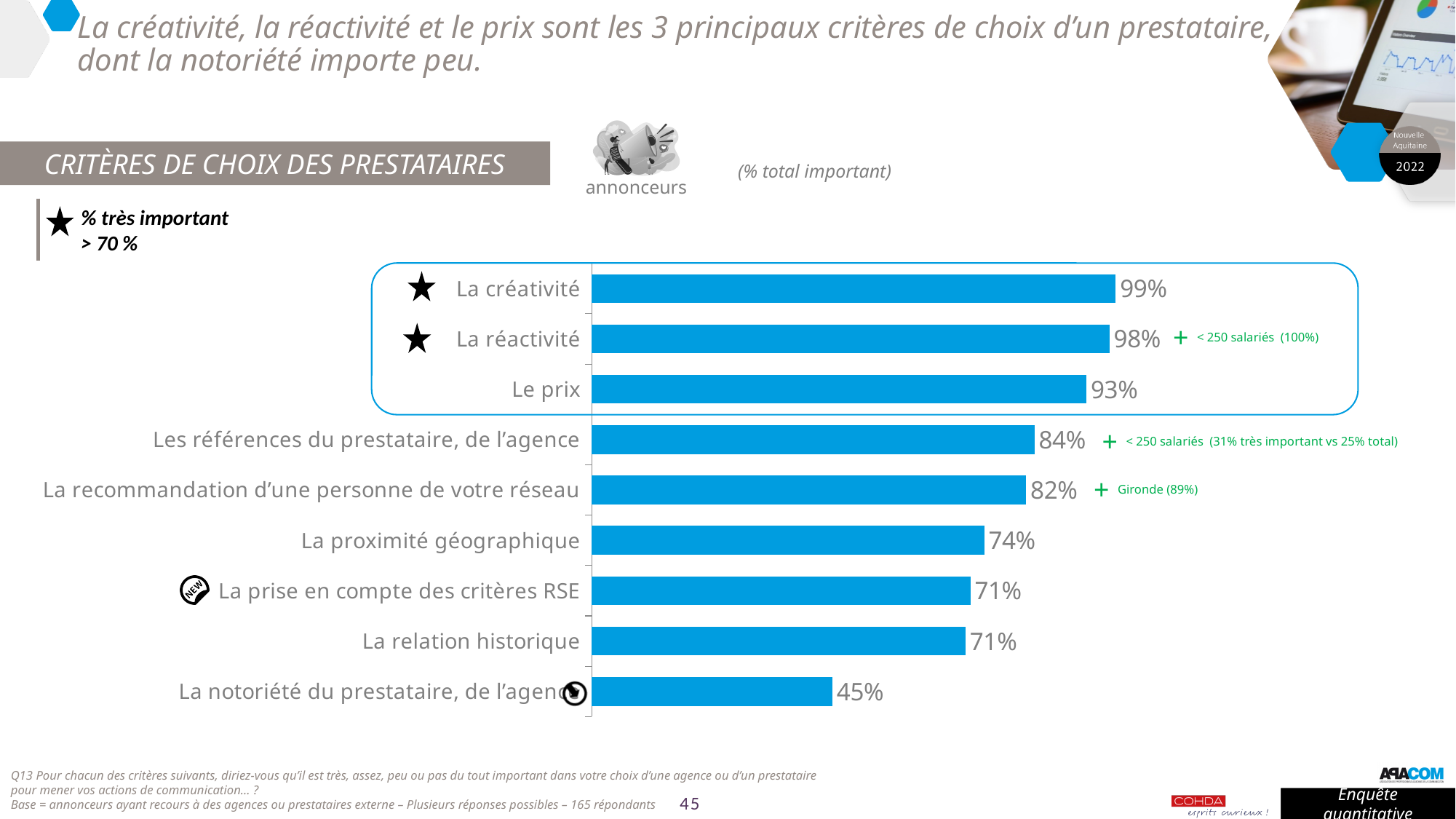
Which criterion has the highest value? La créativité How many criteria are plotted in the chart? 9 What is the difference between the values for La créativité and Le prix? 6 percentage points What is the value for Le prix? 93% What is the value for La proximité géographique? 74% What kind of chart is shown on the slide? Bar chart What is the value for La notoriété du prestataire, de l'agence? 45% Which criterion has the lowest value? La notoriété du prestataire, de l'agence Which is larger, the value for La recommandation d'une personne de votre réseau or the value for La proximité géographique? La recommandation d'une personne de votre réseau What is the difference between the values for Les références du prestataire, de l'agence and La notoriété du prestataire, de l'agence? 39 percentage points What is the value for La créativité? 99% What is the title of the chart section on the slide? CRITÈRES DE CHOIX DES PRESTATAIRES